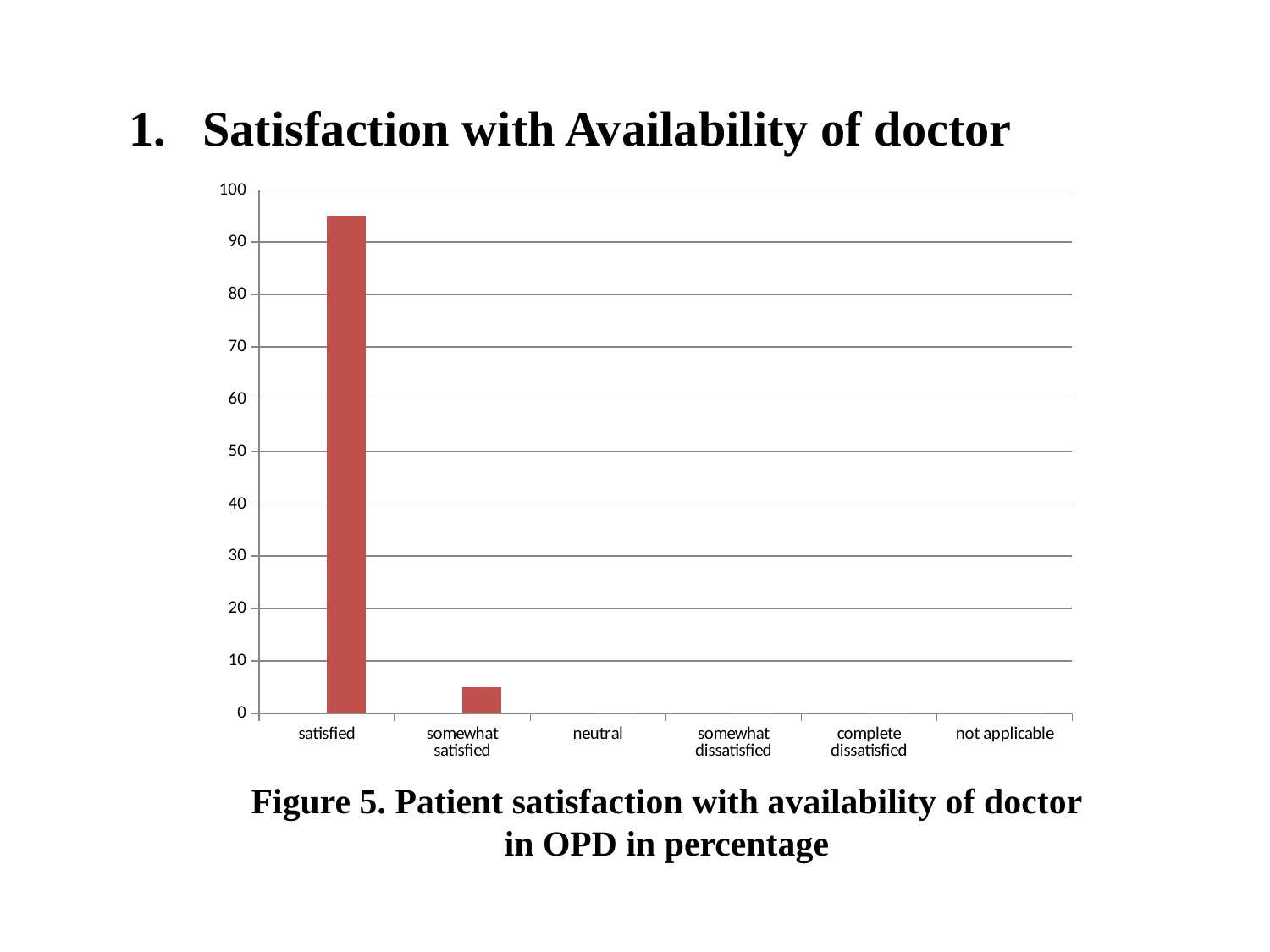
What is the figure caption printed below the chart? Figure 5. Patient satisfaction with availability of doctor in OPD in percentage How many categories are shown on the x axis of the chart? 6 Is the value for satisfied greater or less than 50? greater Do the values rise or fall from satisfied to somewhat satisfied along the x axis? fall What kind of chart is shown on the slide? bar chart Which category has the highest bar in the chart? satisfied Which is larger, the value for satisfied or the value for somewhat satisfied? satisfied Is the value for satisfied greater or less than 90? greater Is the value for somewhat satisfied greater or less than 10? less What is the highest value shown on the y axis of the chart? 100 What is the label of the last category on the x axis? not applicable